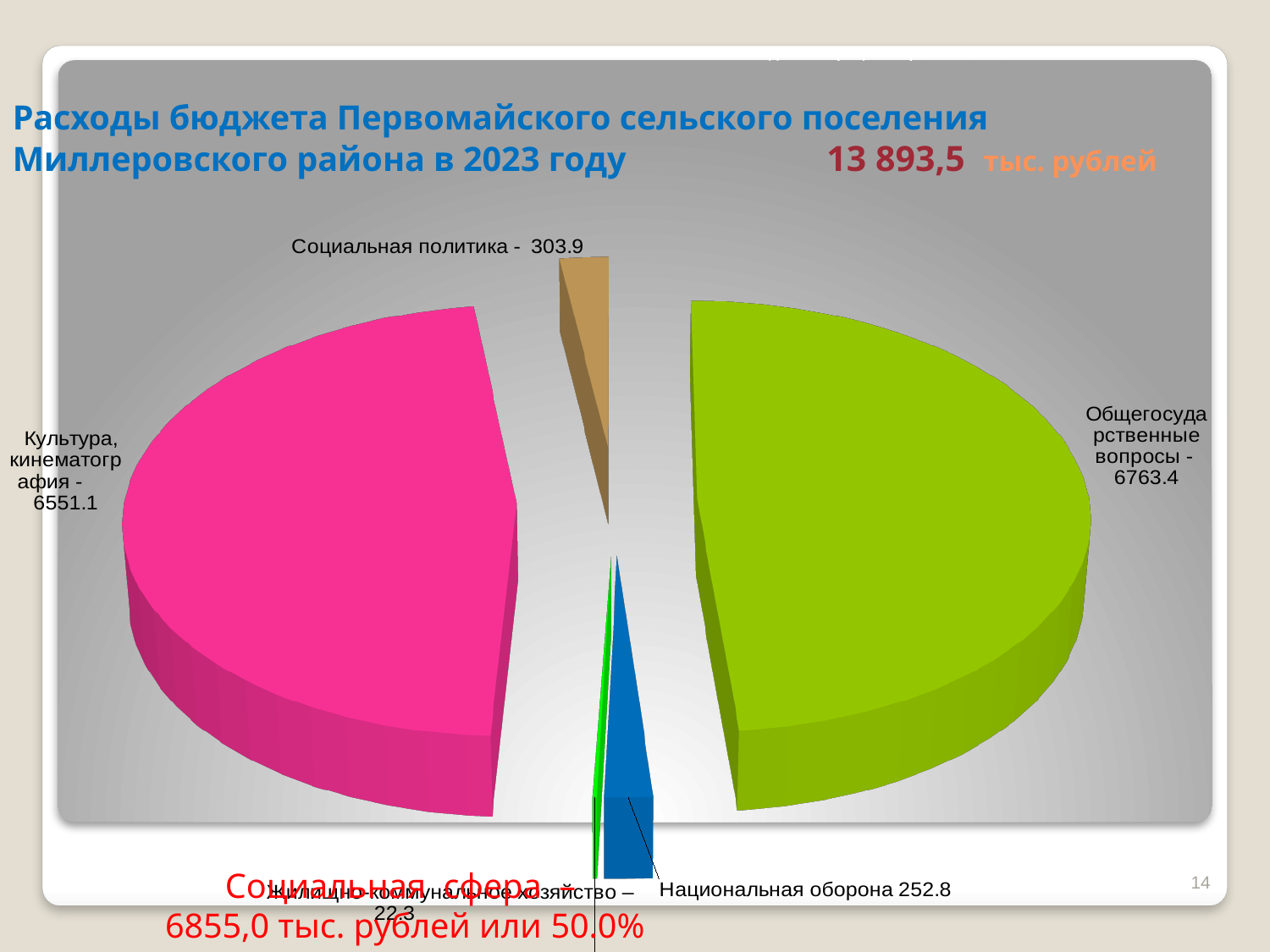
What is the value for Национальная оборона? 252.8 What is the value for Общегосударственные вопросы? 6763.4 What is the difference between the values for Общегосударственные вопросы and Культура, кинематография? 212.3 How many slices does the pie chart have? 5 What is the difference between the values for Социальная политика and Национальная оборона? 51.1 What total amount in тыс. рублей is shown in the slide title? 13 893,5 What colour is the slice for Общегосударственные вопросы? Green What type of chart is shown on the slide? Pie chart Which is larger, the value for Социальная политика or the value for Национальная оборона? Социальная политика What is the value for Социальная политика? 303.9 What is the value for Культура, кинематография? 6551.1 Which category has the largest slice of the pie? Общегосударственные вопросы